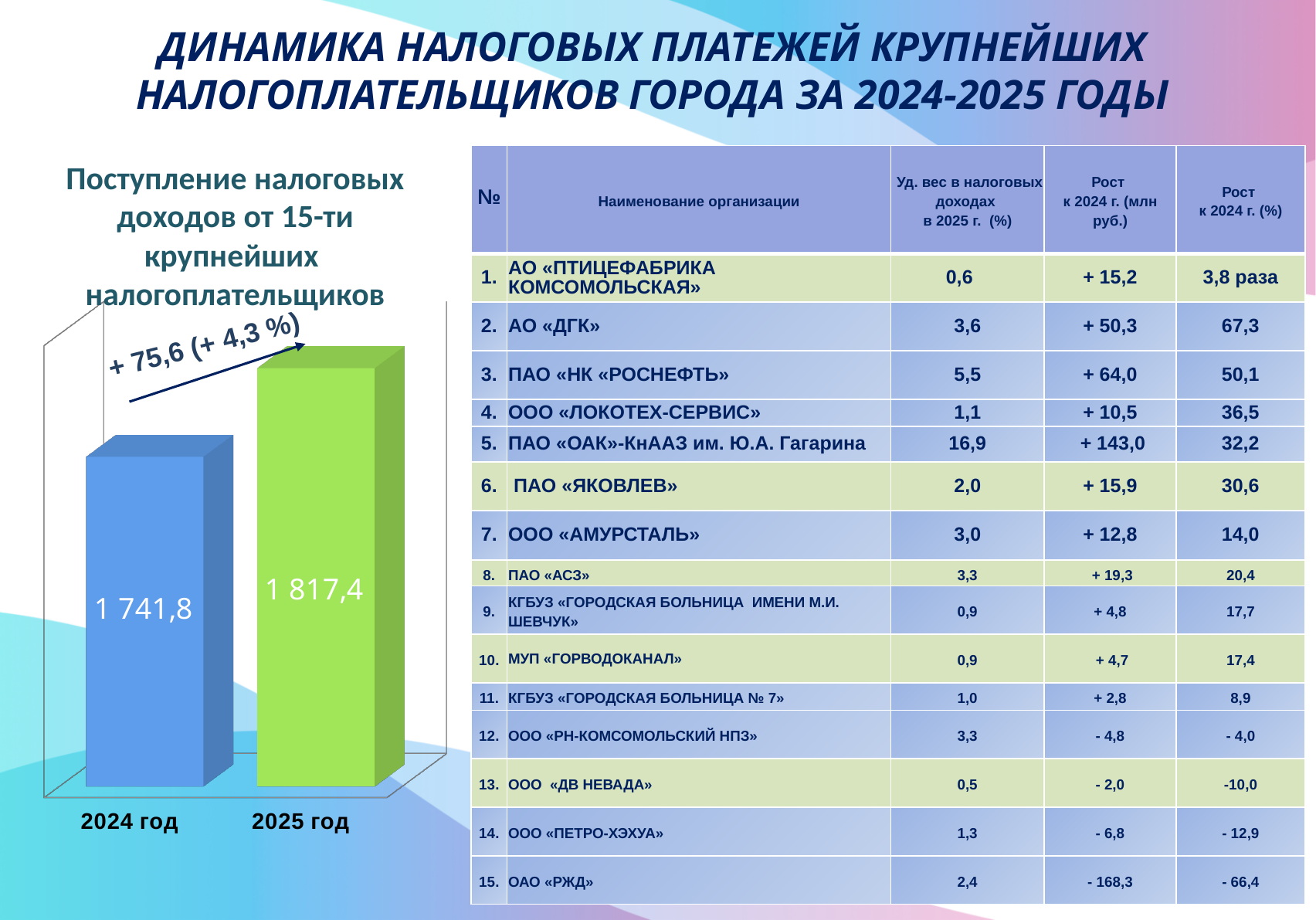
How many bars are plotted in the chart? 2 What is the value of the bar for 2024 год? 1 741,8 Which year has the lower bar in the chart? 2024 год What kind of chart is shown on the left of the slide? bar chart Is the value for 2025 год larger or smaller than the value for 2024 год? larger Which year has the higher bar in the chart? 2025 год What is the difference between the 2025 год and 2024 год bars? 75,6 What percentage growth is written above the bars in the chart? + 4,3 % Do the values rise or fall from 2024 год to 2025 год? rise What is the value of the bar for 2025 год? 1 817,4 What colour is the bar for 2025 год? green